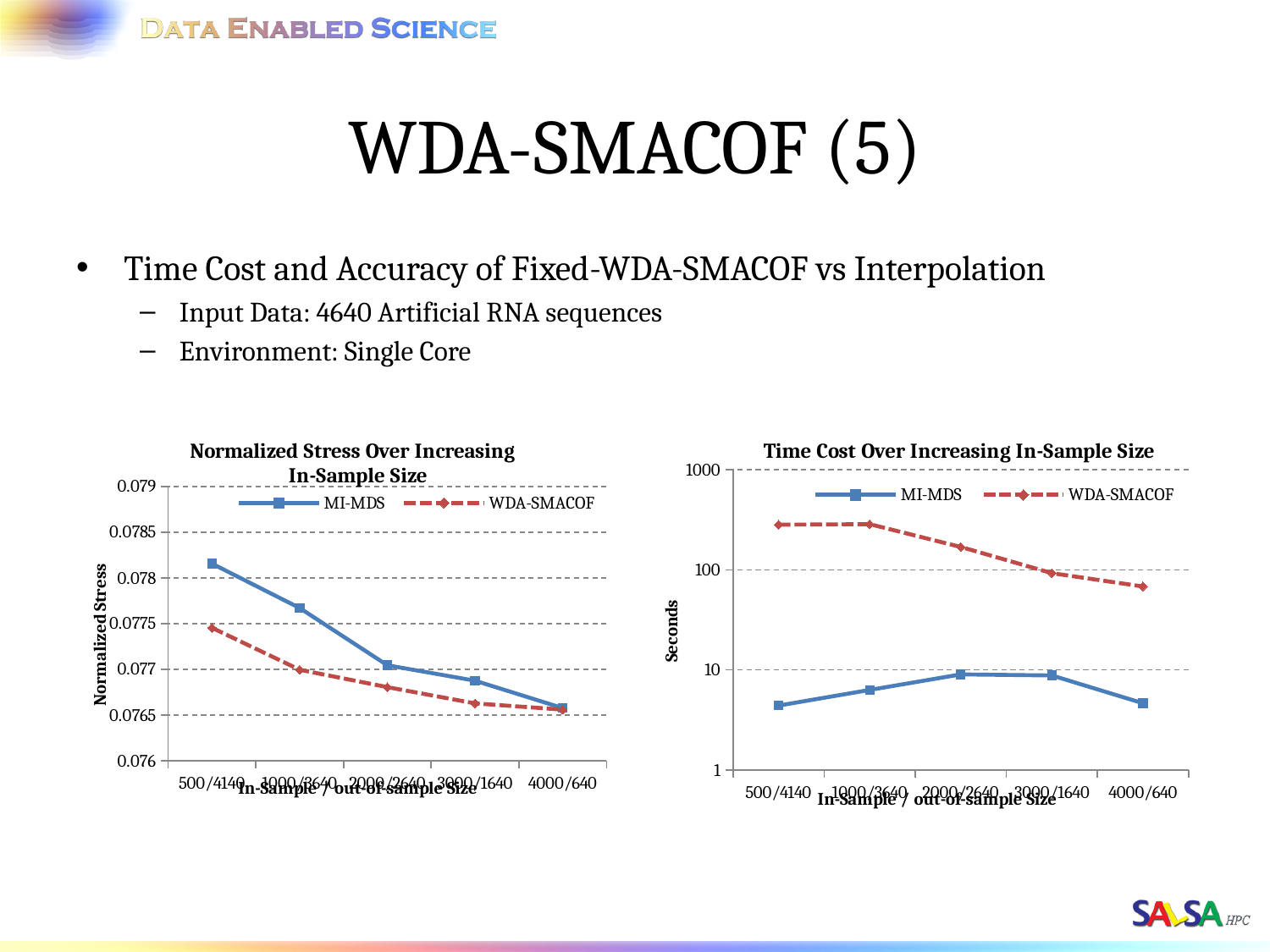
How many series does the legend of the 'Normalized Stress Over Increasing In-Sample Size' chart list? 2 In the 'Normalized Stress Over Increasing In-Sample Size' chart, is the MI-MDS value at 500/4140 greater or less than 0.0775? greater In the 'Time Cost Over Increasing In-Sample Size' chart, at which in-sample/out-of-sample size is the WDA-SMACOF time cost lowest? 4000/640 What kind of chart is the 'Normalized Stress Over Increasing In-Sample Size' chart? Line chart In the 'Normalized Stress Over Increasing In-Sample Size' chart, does the MI-MDS normalized stress rise or fall as the in-sample size increases? Fall In the 'Normalized Stress Over Increasing In-Sample Size' chart, is the WDA-SMACOF value at 500/4140 greater or less than 0.078? less In the 'Time Cost Over Increasing In-Sample Size' chart, is the MI-MDS value at 500/4140 greater or less than 10? less What is the y-axis label of the 'Time Cost Over Increasing In-Sample Size' chart? Seconds In the 'Normalized Stress Over Increasing In-Sample Size' chart, which series has the higher normalized stress at 500/4140? MI-MDS In the 'Time Cost Over Increasing In-Sample Size' chart, which series has the higher time cost at 4000/640? WDA-SMACOF How many in-sample/out-of-sample size categories are shown on the x axis of the 'Normalized Stress Over Increasing In-Sample Size' chart? 5